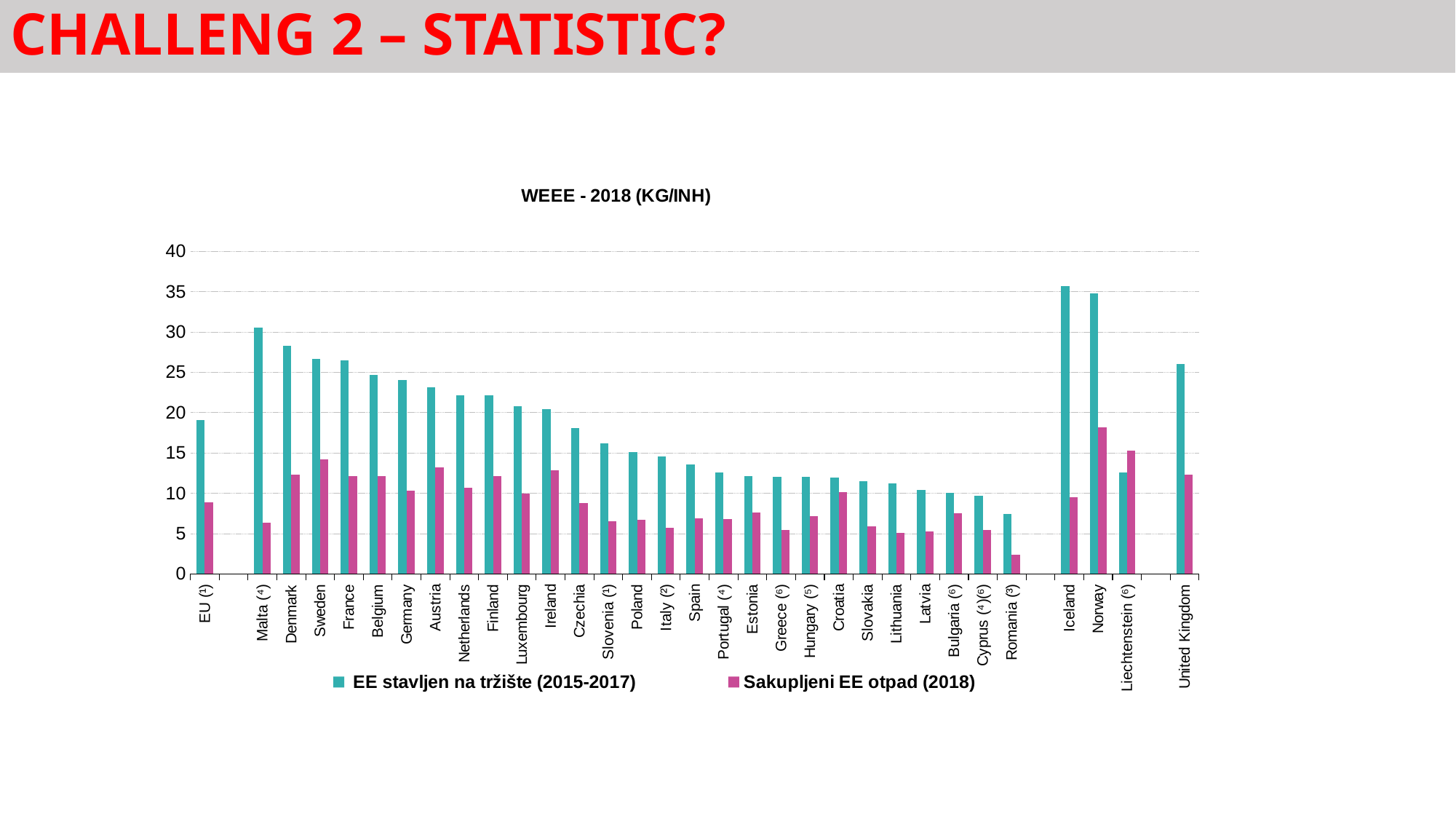
Is the value for Norway in 'Sakupljeni EE otpad (2018)' greater or less than 15? greater Is the value for Denmark in 'EE stavljen na tržište (2015-2017)' greater or less than 25? greater Is the value for Czechia in 'EE stavljen na tržište (2015-2017)' greater or less than 20? less For Liechtenstein, which series has the larger value: 'EE stavljen na tržište (2015-2017)' or 'Sakupljeni EE otpad (2018)'? Sakupljeni EE otpad (2018) Which category has the lowest value for 'Sakupljeni EE otpad (2018)'? Romania (³) What is the title of the chart? WEEE - 2018 (KG/INH) What type of chart is shown on the slide? bar chart Which category has the lowest value for 'EE stavljen na tržište (2015-2017)'? Romania (³) How many series does the legend list? 2 Which is larger for 'EE stavljen na tržište (2015-2017)': Malta or Denmark? Malta (⁴) How many countries/categories are shown on the x axis? 32 Which category has the highest value for 'Sakupljeni EE otpad (2018)'? Norway